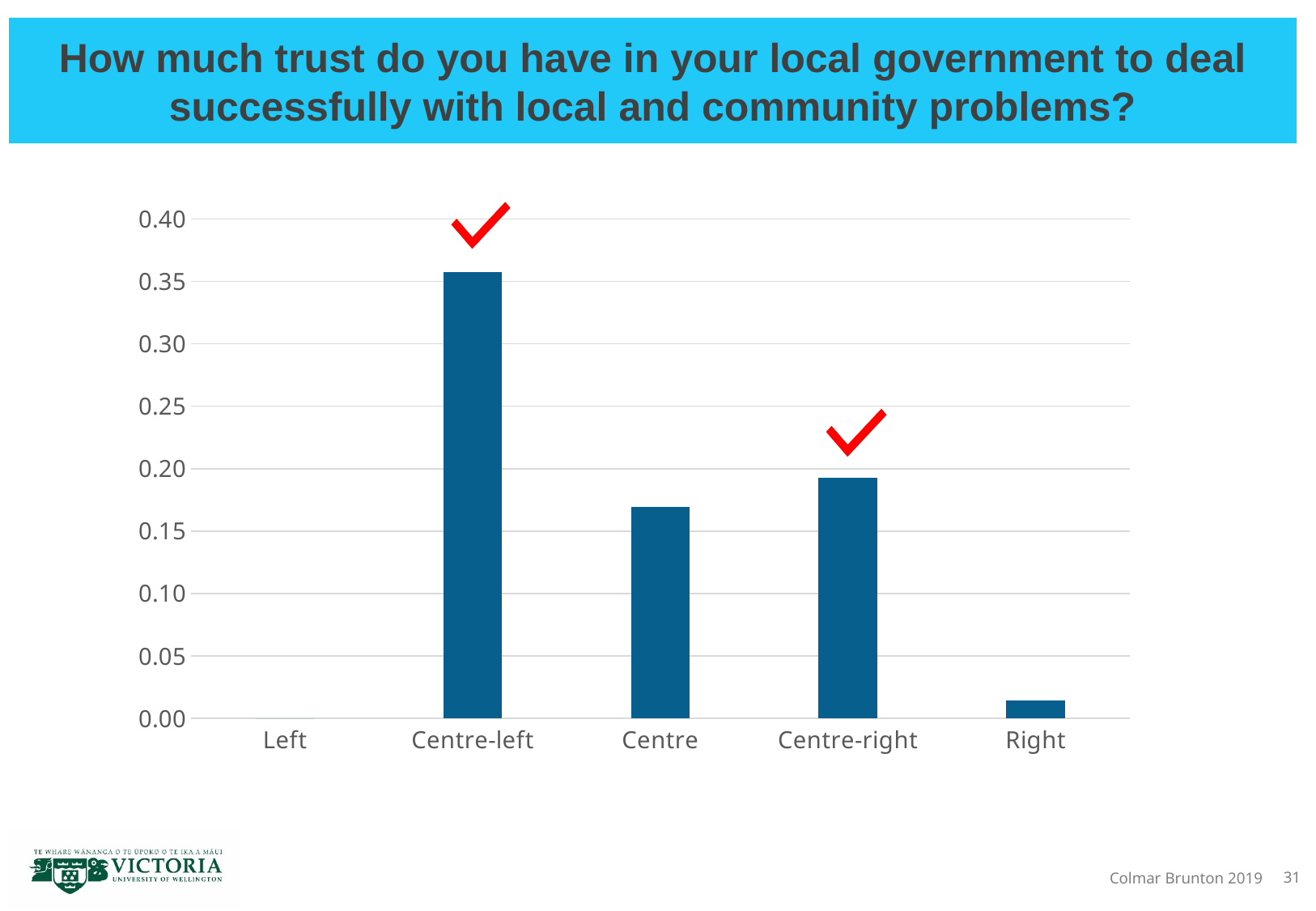
Which is larger, the value for Centre-left or the value for Centre-right? Centre-left Which is larger, the value for Centre or the value for Right? Centre Is the value for Centre greater or less than 0.20? less Is the value for Centre greater or less than 0.15? greater What kind of chart is shown on the slide? bar chart Is the value for Right greater or less than 0.05? less Which category has the highest value in the chart? Centre-left How many categories are shown on the x axis of the chart? 5 Which category has the lowest value in the chart? Left Which two categories have a red check mark above their bars? Centre-left and Centre-right